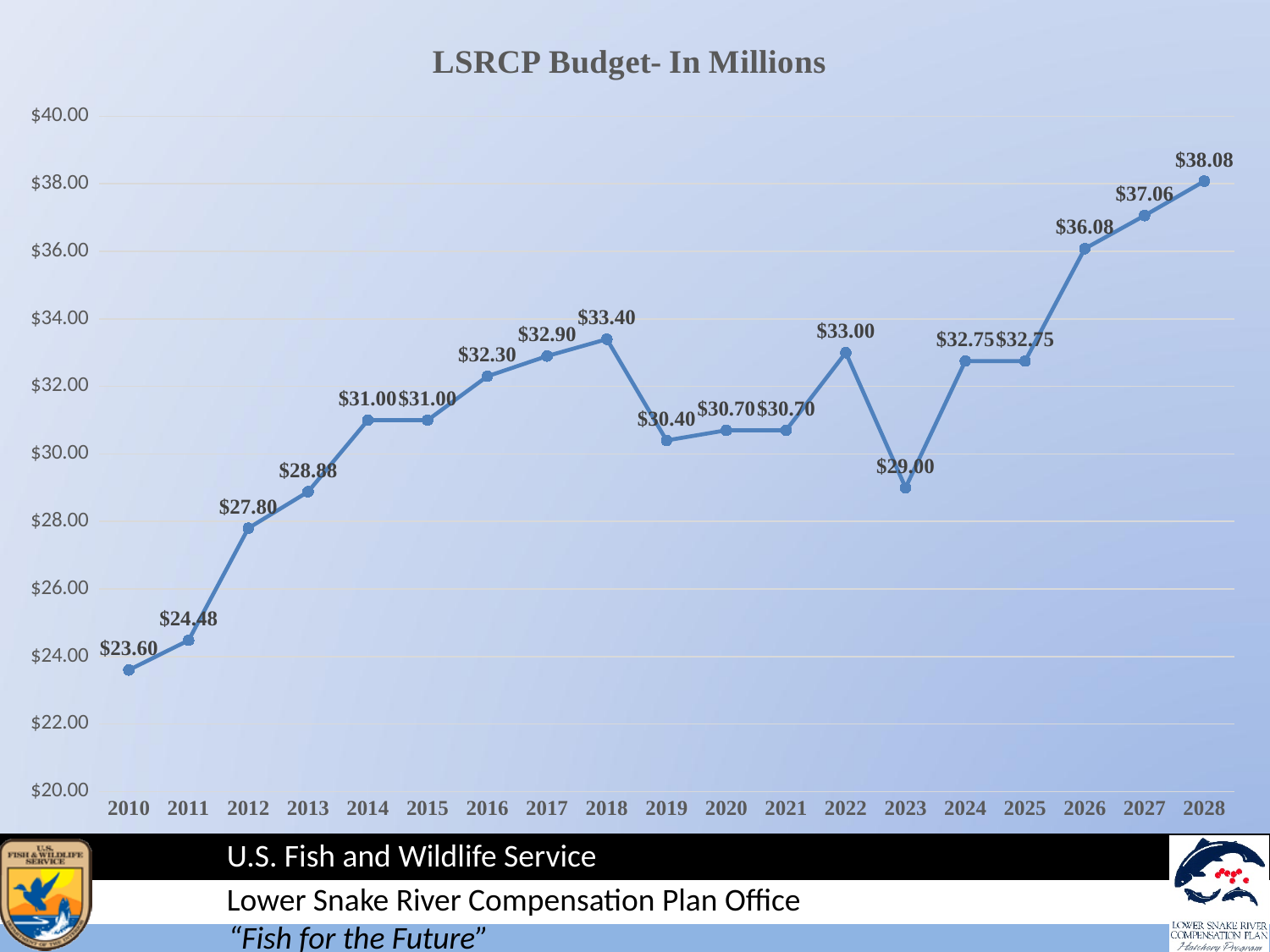
What is the difference between the budget values for 2022 and 2023? $4.00 What is the budget value for 2018? $33.40 What kind of chart is shown on the slide? Line chart Which year has the lowest budget value? 2010 How many years are plotted on the chart? 19 Which year has a larger budget value, 2019 or 2022? 2022 What is the budget value for 2010? $23.60 What is the budget value for 2023? $29.00 Is the budget value for 2026 greater or less than $36.00? greater Which year has the highest budget value? 2028 What is the difference between the budget values for 2028 and 2027? $1.02 What is the title of the chart? LSRCP Budget- In Millions